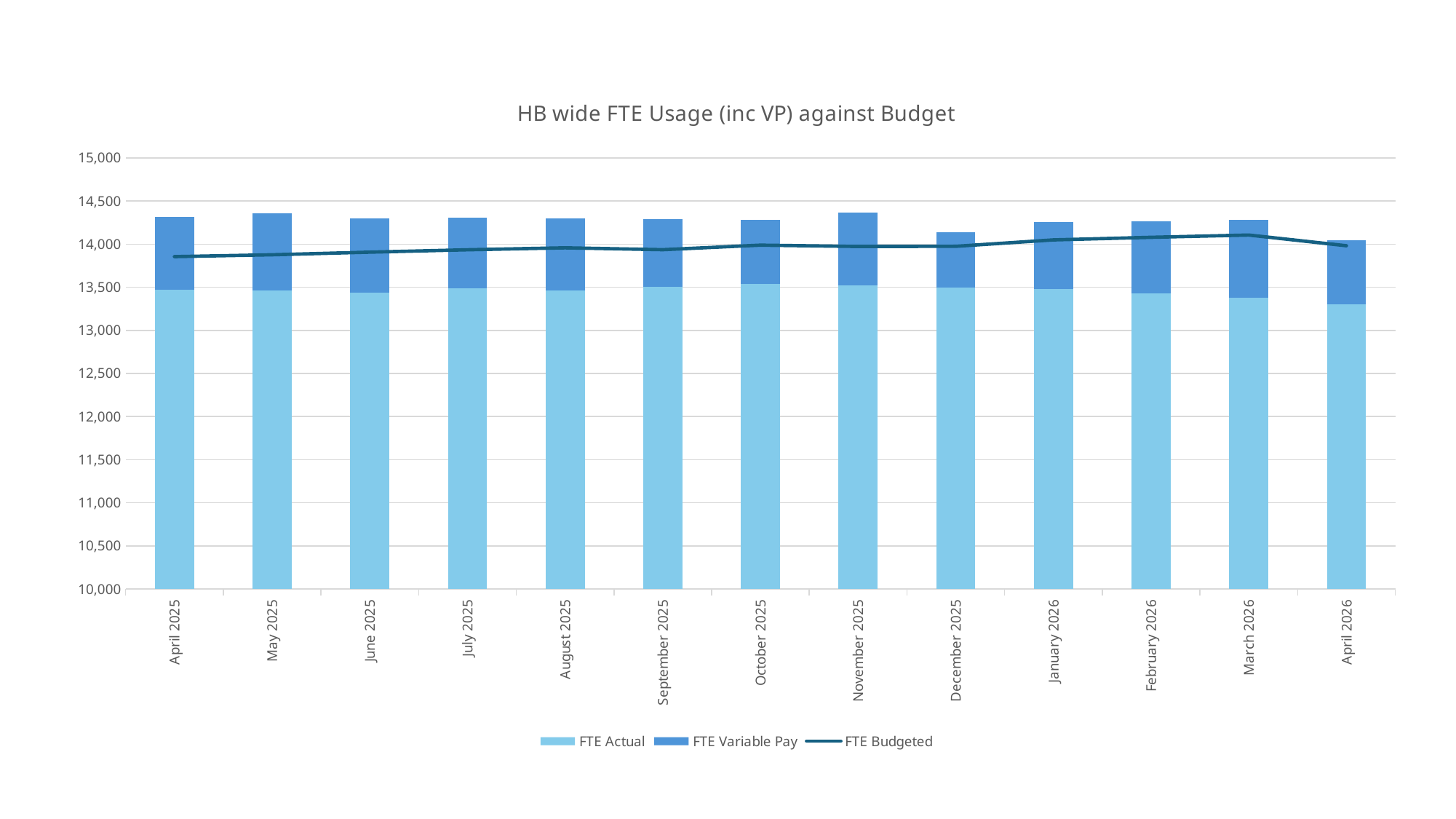
How many months are shown along the x axis? 13 Is the total stacked bar for December 2025 greater or less than 14,000? greater Which month has the lowest FTE Actual value? April 2026 Which month has the lowest total stacked bar (FTE Actual plus FTE Variable Pay)? April 2026 Which month has the lowest FTE Budgeted value? April 2025 What is the title of the chart? HB wide FTE Usage (inc VP) against Budget What kind of chart is shown on the slide? A stacked bar chart with a line series How many series does the legend list? 3 Is the FTE Budgeted value for April 2025 greater or less than 14,000? less Which series is drawn as a line rather than bars? FTE Budgeted Is the FTE Actual value for April 2026 greater or less than 13,500? less Does the FTE Budgeted line generally rise or fall from April 2025 to March 2026? rise